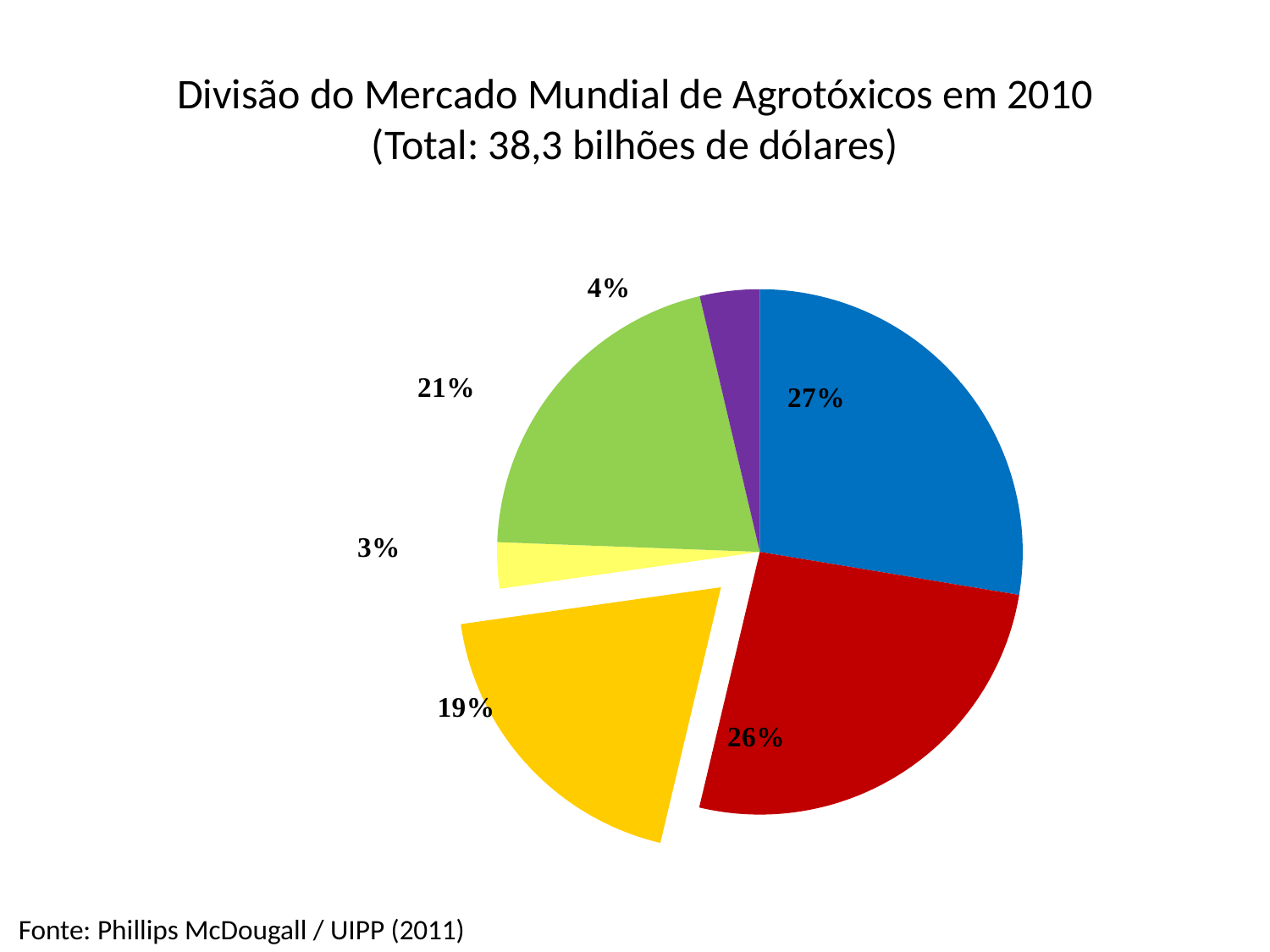
What percentage is shown for the purple slice of the pie chart? 4% What is the title of the chart? Divisão do Mercado Mundial de Agrotóxicos em 2010 (Total: 38,3 bilhões de dólares) How many slices does the pie chart have? 6 What percentage is shown for the red slice of the pie chart? 26% Which is larger, the green slice or the exploded yellow slice? the green slice What percentage is shown for the slice that is pulled out (exploded) from the pie? 19% What percentage is shown for the green slice of the pie chart? 21% What kind of chart is shown on the slide? pie chart Which slice has the smallest share of the pie chart? the light yellow slice (3%) What is the difference in percentage points between the blue slice and the red slice? 1 percentage point What percentage is shown for the blue slice of the pie chart? 27% Which slice has the largest share of the pie chart? the blue slice (27%)